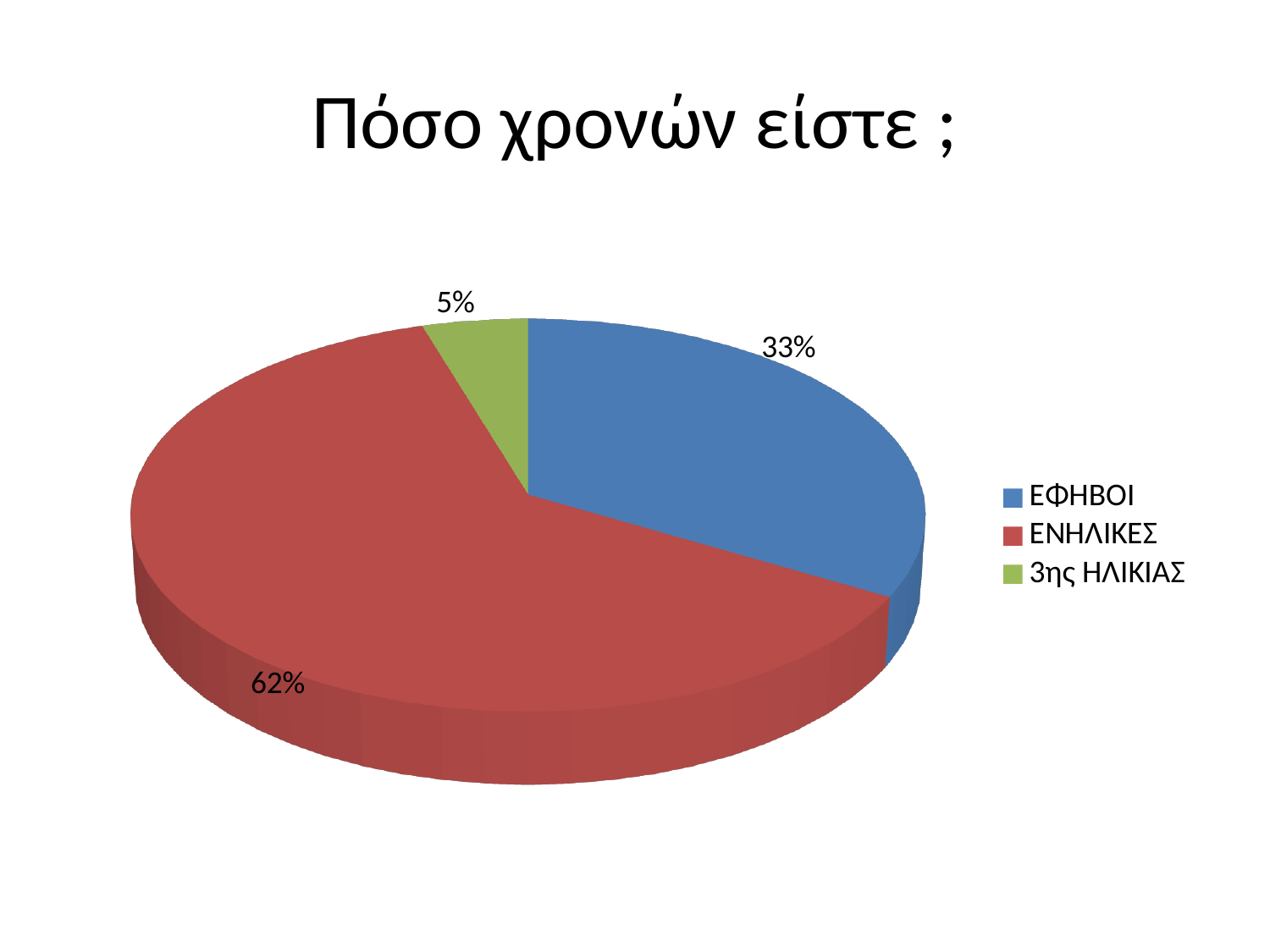
How many categories does the pie chart show? 3 What is the difference in percentage points between ΕΦΗΒΟΙ and 3ης ΗΛΙΚΙΑΣ? 28 What share of the pie does ΕΝΗΛΙΚΕΣ represent? 62% Which colour represents ΕΝΗΛΙΚΕΣ in the pie chart? Red What kind of chart is shown on the slide? Pie chart What share of the pie does ΕΦΗΒΟΙ represent? 33% Which is larger, the share for ΕΦΗΒΟΙ or the share for 3ης ΗΛΙΚΙΑΣ? ΕΦΗΒΟΙ What is the difference in percentage points between ΕΝΗΛΙΚΕΣ and ΕΦΗΒΟΙ? 29 What share of the pie does 3ης ΗΛΙΚΙΑΣ represent? 5% Which category has the smallest slice of the pie? 3ης ΗΛΙΚΙΑΣ What is the title of the chart? Πόσο χρονών είστε ; Which category has the largest slice of the pie? ΕΝΗΛΙΚΕΣ